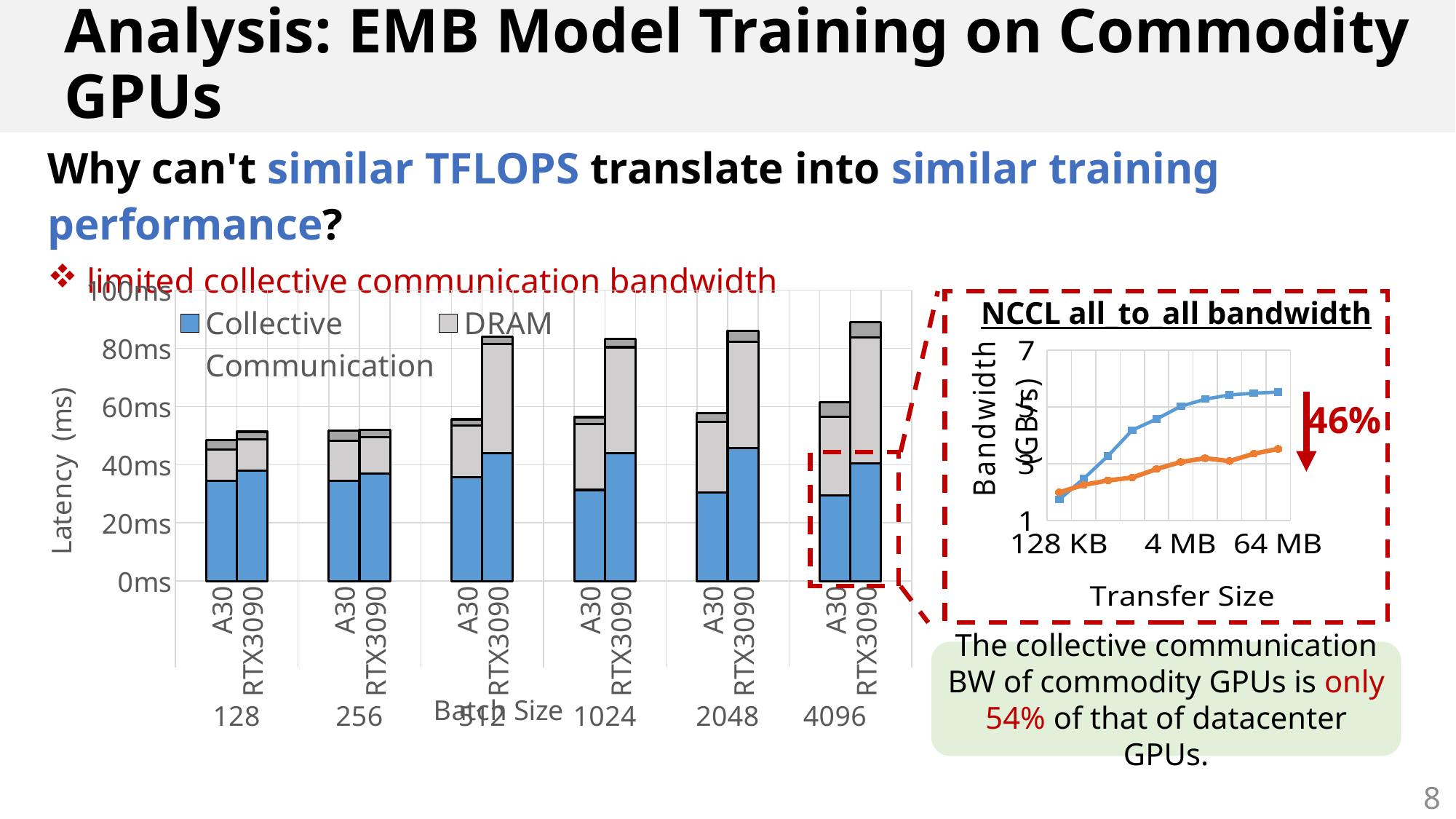
In the 'NCCL all_to_all bandwidth' chart, is the bandwidth of the orange line at 64 MB greater or less than 4 GB/s? less In the 'NCCL all_to_all bandwidth' chart, what is the x axis label? Transfer Size In the left latency chart, is the total latency for RTX3090 at batch size 512 greater or less than 80ms? greater In the left latency chart, at batch size 512, which GPU has the larger total latency, A30 or RTX3090? RTX3090 What type of chart is the 'NCCL all_to_all bandwidth' chart? line chart In the left latency chart, is the Collective Communication latency for A30 at batch size 128 greater or less than 40ms? less What type of chart is the left chart showing latency by batch size? bar chart In the 'NCCL all_to_all bandwidth' chart, does the blue line rise or fall as transfer size increases? rise In the left latency chart, how many batch sizes are shown on the x axis? 6 In the left latency chart, how many series does the legend list? 2 In the left latency chart, what are the two series named in the legend? Collective Communication and DRAM